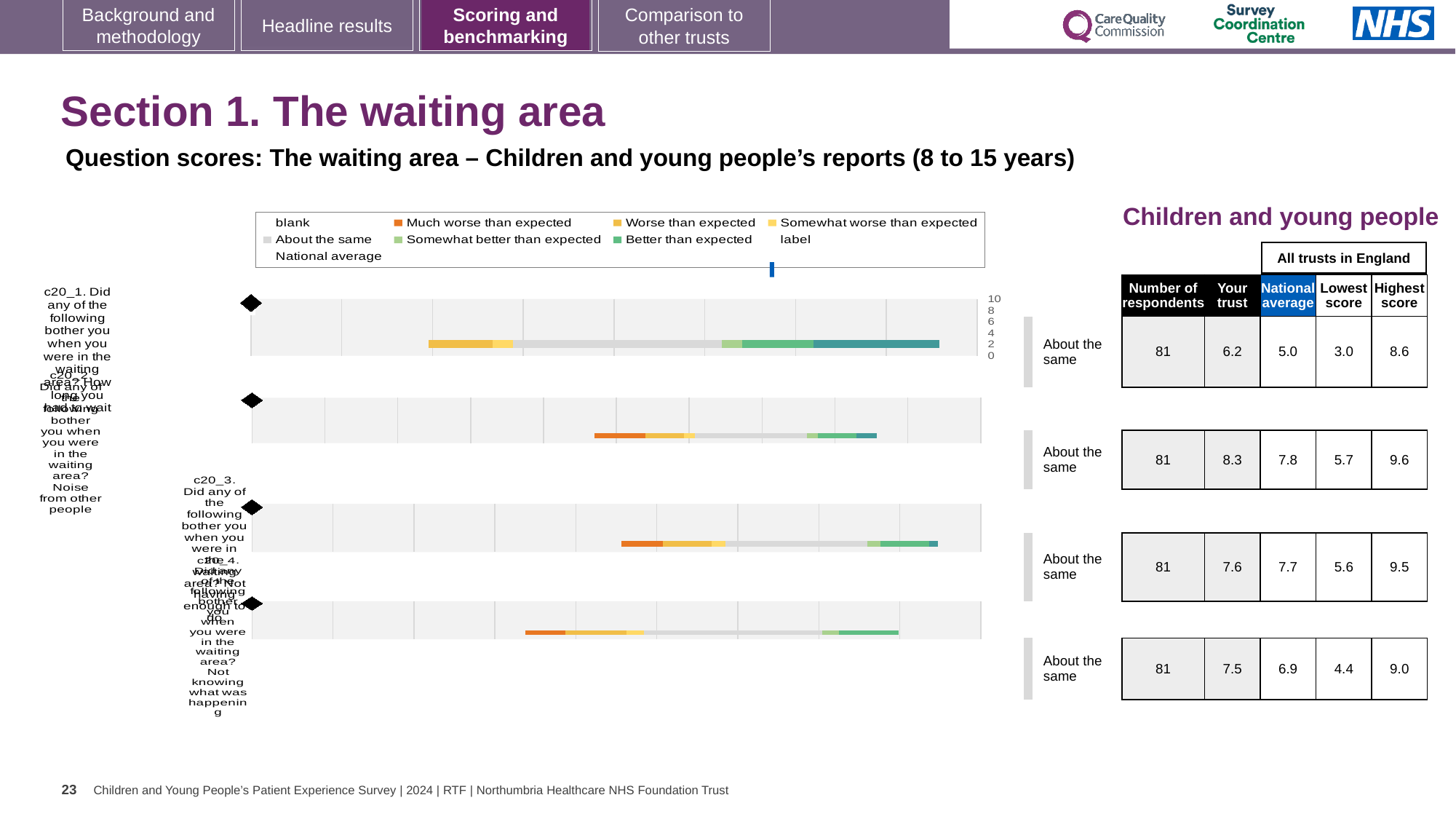
What is the national average score for the first question (c20_1)? 5.0 What kind of chart is shown on the slide? bar chart What is the highest score in England for the second question (c20_2)? 9.6 How many respondents answered each of the four questions? 81 What is the difference between the 'Your trust' score and the national average for the first question (c20_1)? 1.2 How many question bars are plotted in the chart? 4 What is the lowest score in England for the fourth question (c20_4, not knowing what was happening)? 4.4 What is the 'Your trust' score for the first question (c20_1, noise from other people)? 6.2 Which question has the lowest 'Your trust' score? c20_1 (first question), 6.2 For the third question (c20_3), which is larger: the 'Your trust' score or the national average? National average (7.7) Which question has the highest 'Your trust' score? c20_2 (second question), 8.3 How many entries does the chart legend list? 9